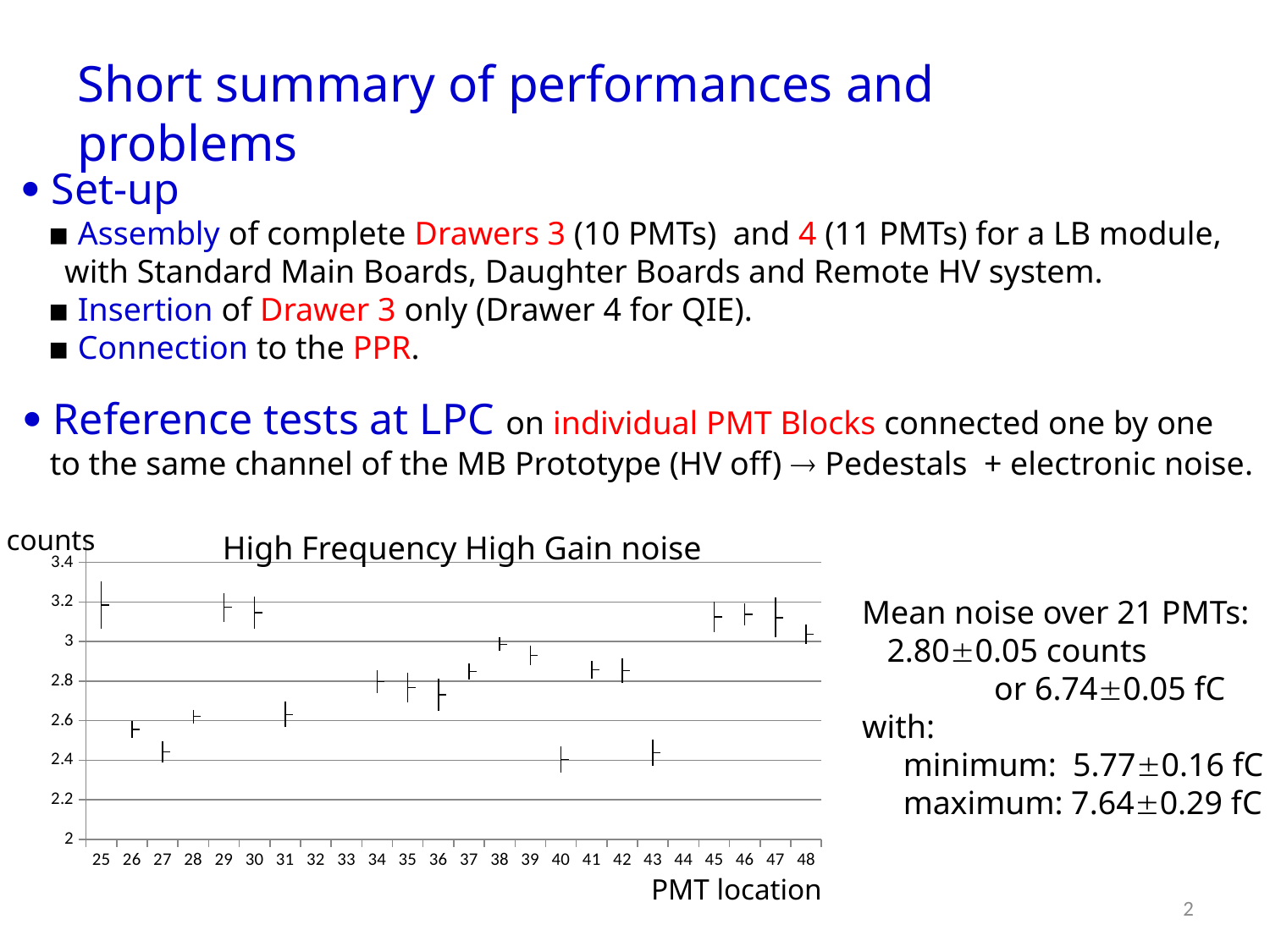
What is the label of the x axis of the chart? PMT location What kind of chart is shown on the slide? scatter chart with error bars Is the noise value for PMT location 29 greater or less than 3? greater What is the title of the chart on the slide? High Frequency High Gain noise Which has the higher noise value, PMT location 25 or PMT location 27? PMT location 25 Is the noise value for PMT location 40 greater or less than 2.6? less Is the noise value for PMT location 43 greater or less than 2.8? less Which has the higher noise value, PMT location 38 or PMT location 40? PMT location 38 How many PMT locations are labelled on the x axis of the chart? 24